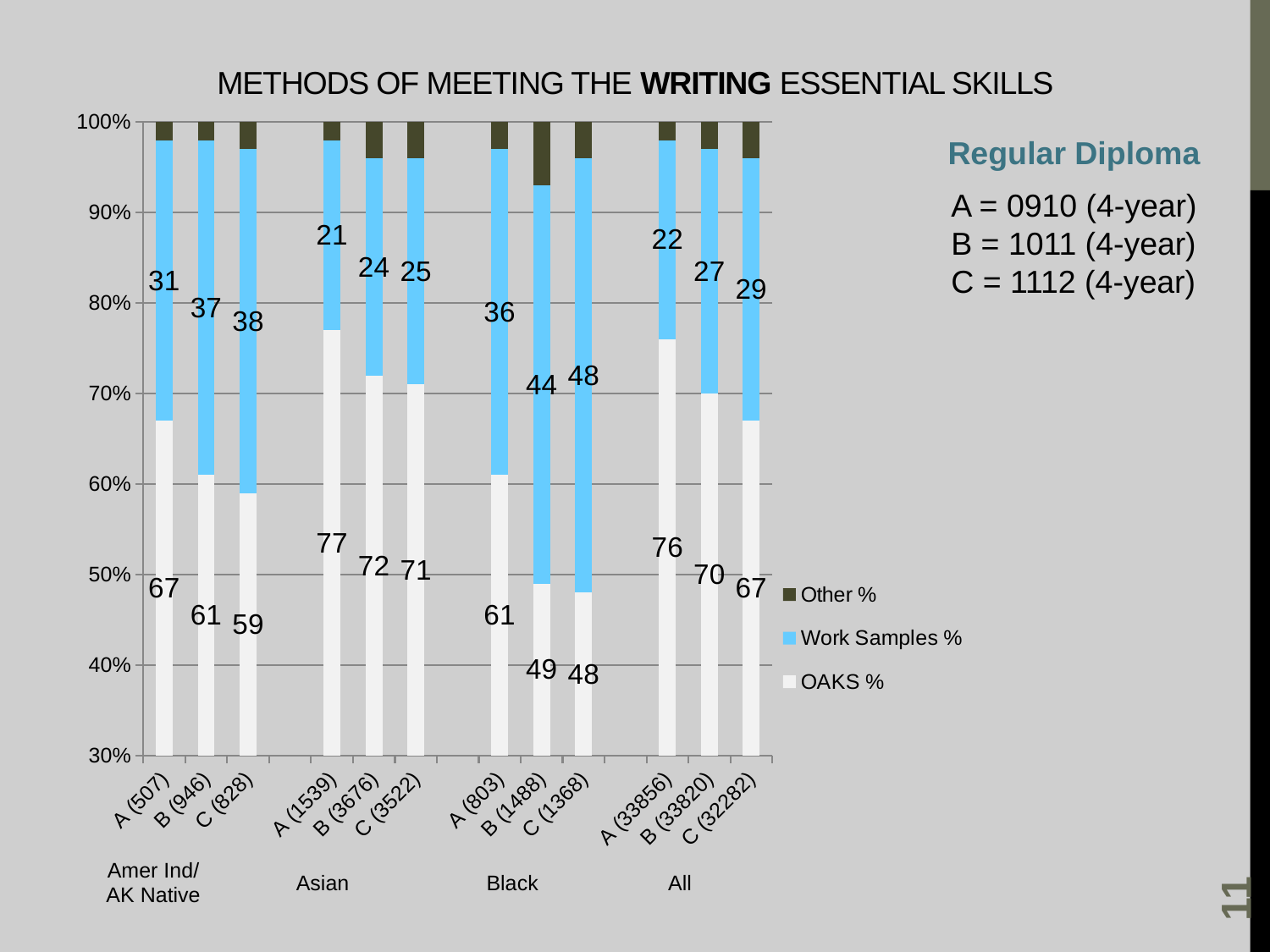
What is the OAKS % value for the Asian A (1539) bar? 77 Which bar has the highest OAKS % value? Asian A (1539) What is the Work Samples % value for the Black C (1368) bar? 48 Which bar has the lowest OAKS % value? Black C (1368) Which series is shown in light blue in the legend? Work Samples % How many bars are plotted in the chart? 12 Do the OAKS % values for the All group rise or fall from A to C? fall What is the OAKS % value for the All B (33820) bar? 70 Which is larger, the Work Samples % for Black B (1488) or for All B (33820)? Black B (1488) What is the difference between the OAKS % values for Amer Ind/AK Native A (507) and C (828)? 8 What kind of chart is shown on the slide? stacked bar chart How many series does the legend list? 3